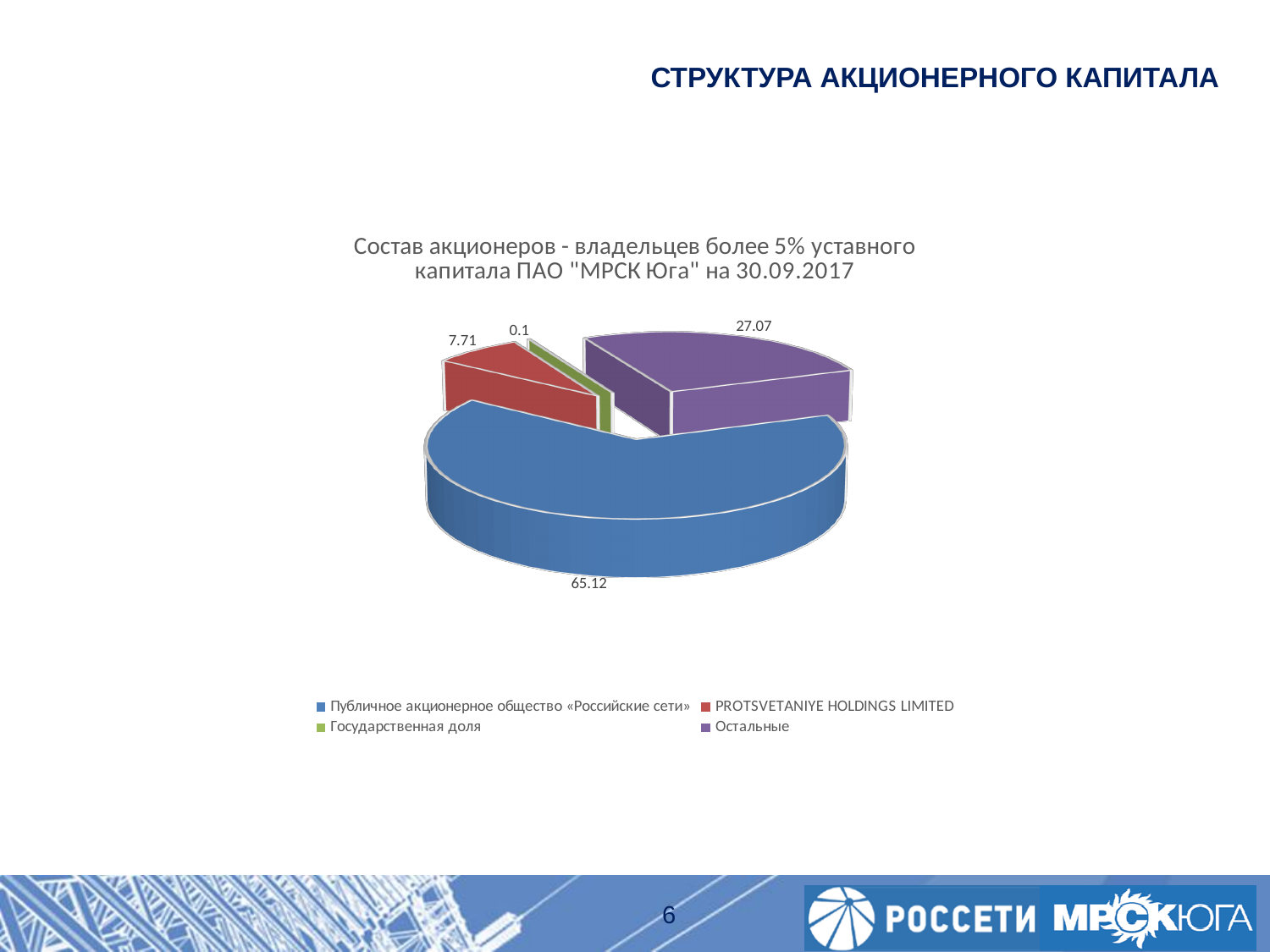
What is the value for PROTSVETANIYE HOLDINGS LIMITED? 7.71 Which is larger, the value for Остальные or the value for PROTSVETANIYE HOLDINGS LIMITED? Остальные How many slices does the pie chart have? 4 How many entries does the legend list? 4 What is the value for Государственная доля? 0.1 What kind of chart is shown on the slide? Pie chart What colour is the slice for Остальные? Purple Which category has the smallest slice of the pie? Государственная доля What is the difference between the values for Публичное акционерное общество «Российские сети» and Остальные? 38.05 What is the value for Остальные? 27.07 Which category has the largest slice of the pie? Публичное акционерное общество «Российские сети» What is the value for Публичное акционерное общество «Российские сети»? 65.12